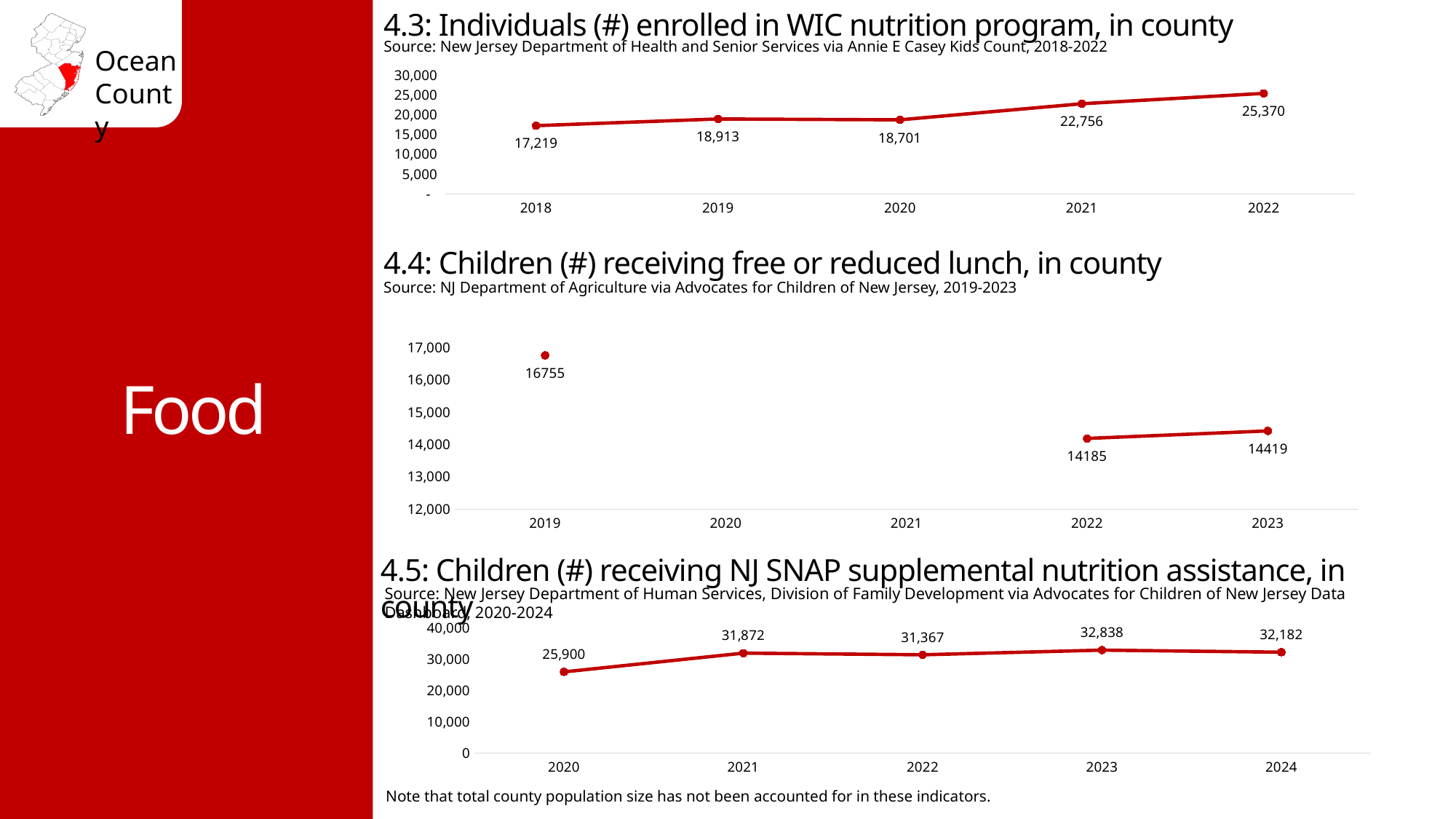
In the chart '4.4: Children (#) receiving free or reduced lunch, in county', what is the value for 2019? 16755 In the chart '4.3: Individuals (#) enrolled in WIC nutrition program, in county', which year has the highest value? 2022 In the chart '4.5: Children (#) receiving NJ SNAP supplemental nutrition assistance, in county', is the value for 2020 greater or less than 30,000? less What kind of chart is '4.5: Children (#) receiving NJ SNAP supplemental nutrition assistance, in county'? line chart In the chart '4.3: Individuals (#) enrolled in WIC nutrition program, in county', how many years are plotted? 5 In the chart '4.4: Children (#) receiving free or reduced lunch, in county', what is the difference between the 2023 and 2022 values? 234 In the chart '4.5: Children (#) receiving NJ SNAP supplemental nutrition assistance, in county', which year has the lowest value? 2020 In the chart '4.5: Children (#) receiving NJ SNAP supplemental nutrition assistance, in county', what is the value for 2023? 32,838 In the chart '4.3: Individuals (#) enrolled in WIC nutrition program, in county', which year has the lowest value? 2018 In the chart '4.4: Children (#) receiving free or reduced lunch, in county', which is larger, the value for 2022 or 2023? 2023 In the chart '4.3: Individuals (#) enrolled in WIC nutrition program, in county', what is the difference between the 2022 and 2021 values? 2,614 In the chart '4.3: Individuals (#) enrolled in WIC nutrition program, in county', what is the value for 2020? 18,701